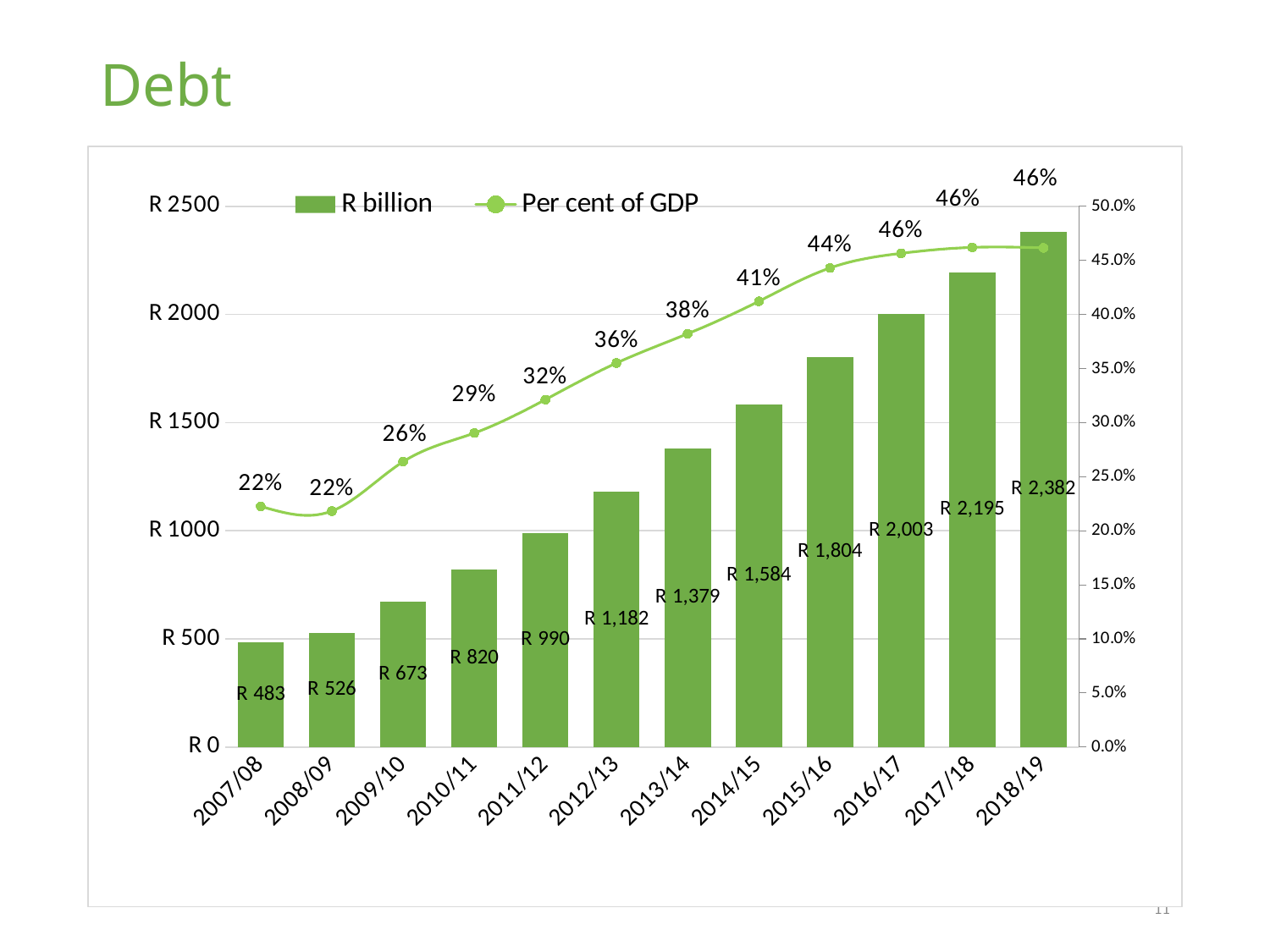
What is the R billion value for 2011/12? R 990 What is the difference in R billion between 2017/18 and 2016/17? R 192 What kind of chart is this? Combined bar and line chart Do the R billion values rise or fall from 2007/08 to 2018/19? Rise What is the title of the slide? Debt How many series does the legend list? 2 Which year has the highest R billion value? 2018/19 What is the R billion value for 2018/19? R 2,382 Which year has the lowest R billion value? 2007/08 What is the Per cent of GDP value for 2013/14? 38% How many years are shown on the x axis? 12 Which is larger, the R billion value for 2012/13 or for 2013/14? 2013/14